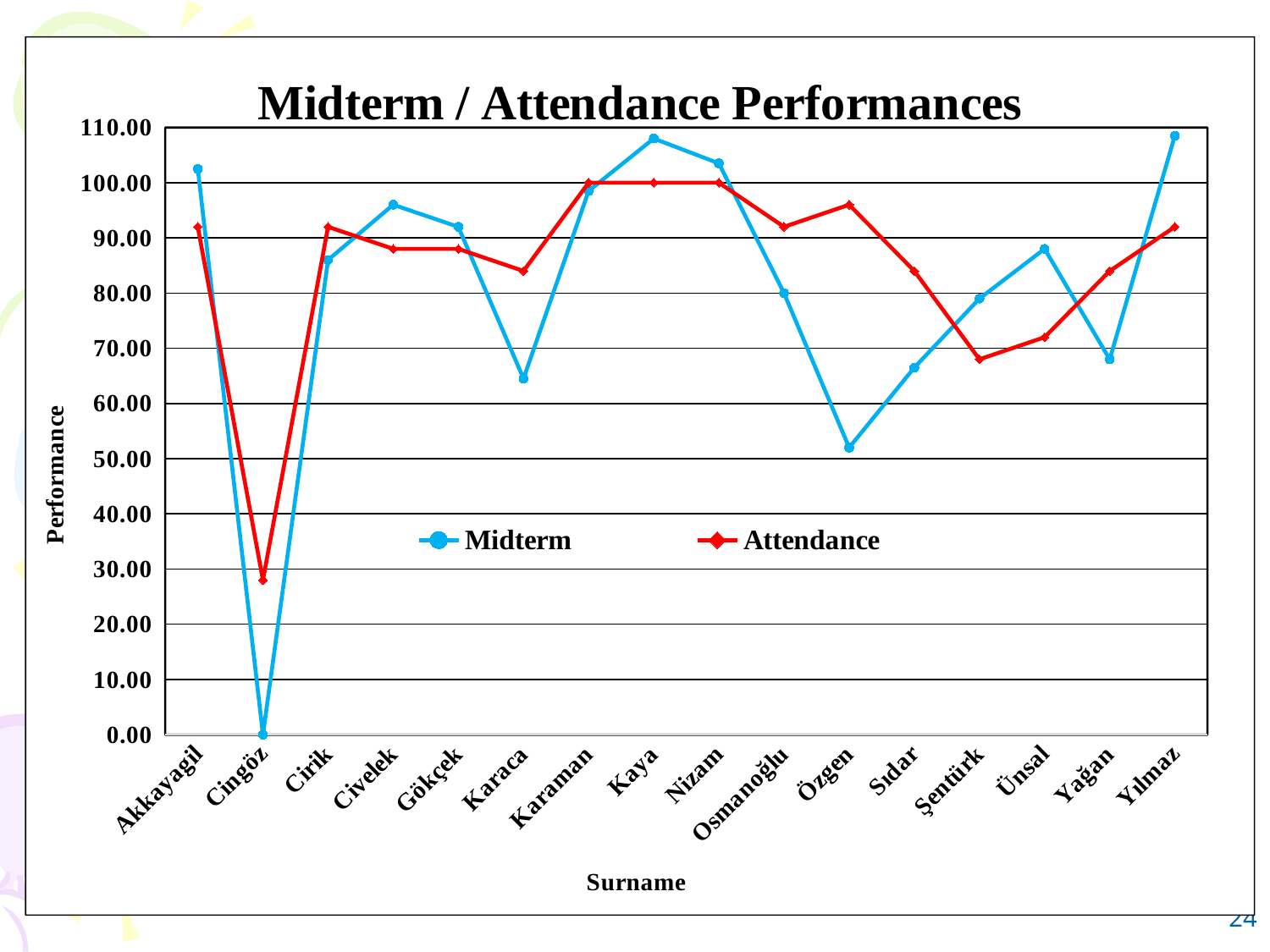
Which surname has the lowest Attendance value? Cingöz How many series does the legend list? 2 For Akkayagil, which is larger: the Midterm value or the Attendance value? Midterm Is the Midterm value for Akkayagil greater or less than 100.00? greater How many surnames are plotted along the x axis? 16 For Özgen, which is larger: the Midterm value or the Attendance value? Attendance Is the Midterm value for Özgen greater or less than 60.00? less What is the title of the chart? Midterm / Attendance Performances What is the Attendance value for Kaya? 100.00 What kind of chart is shown on the slide? line chart What is the Midterm value for Cingöz? 0.00 Which surname has the lowest Midterm value? Cingöz